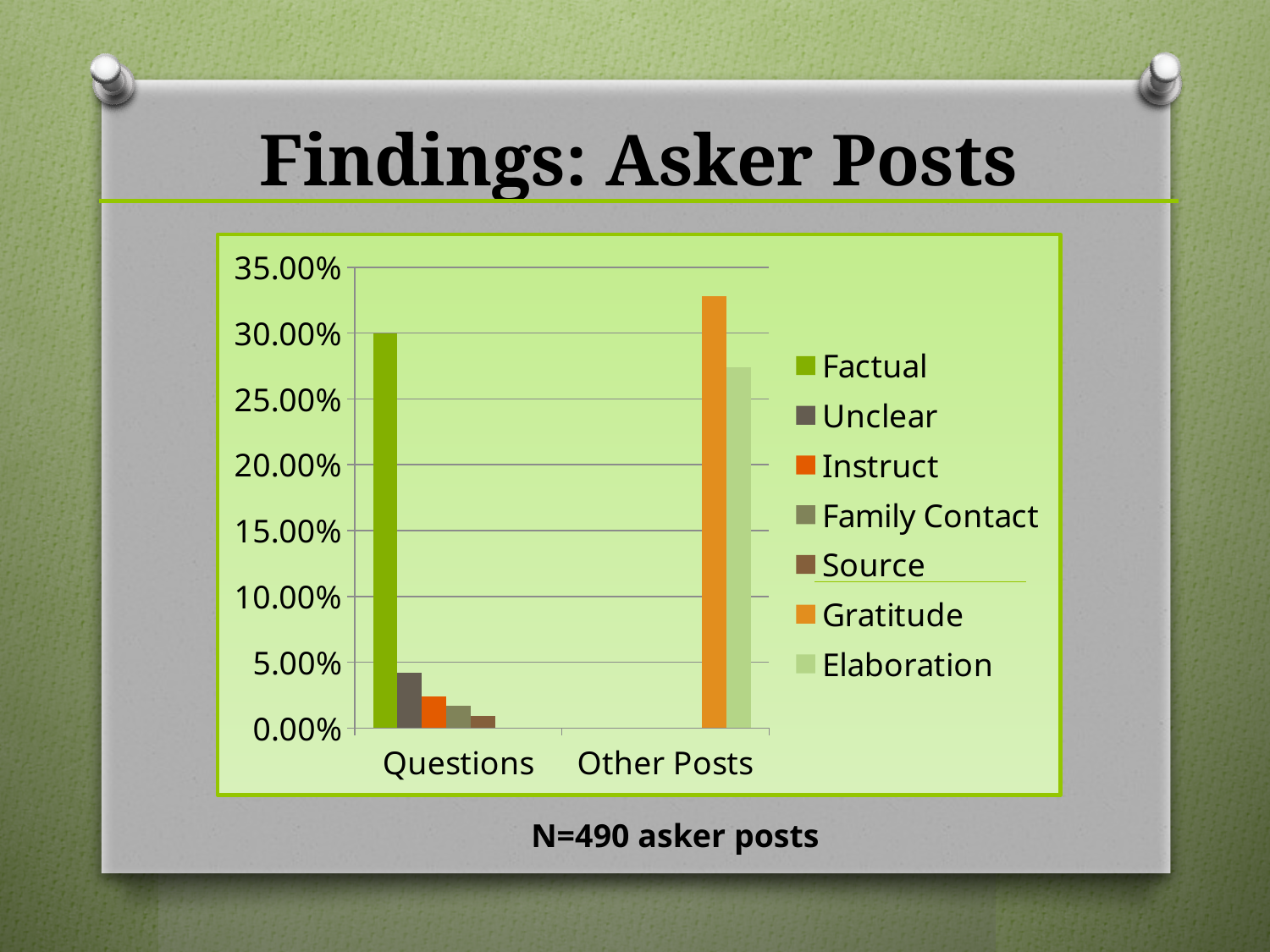
What sample size is stated below the chart? N=490 asker posts Is the value for Elaboration under Other Posts greater or less than 30.00%? less Is the value for Factual under Questions greater or less than 25.00%? greater Which is larger, the Factual bar under Questions or the Gratitude bar under Other Posts? Gratitude How many categories are shown on the x axis? 2 Is the value for Unclear under Questions greater or less than 5.00%? less How many series does the legend list? 7 Which is larger, the Factual bar under Questions or the Elaboration bar under Other Posts? Factual Which series has the tallest bar in the chart? Gratitude What kind of chart is shown on the slide? bar chart Which series has the shortest bar in the Questions category? Source